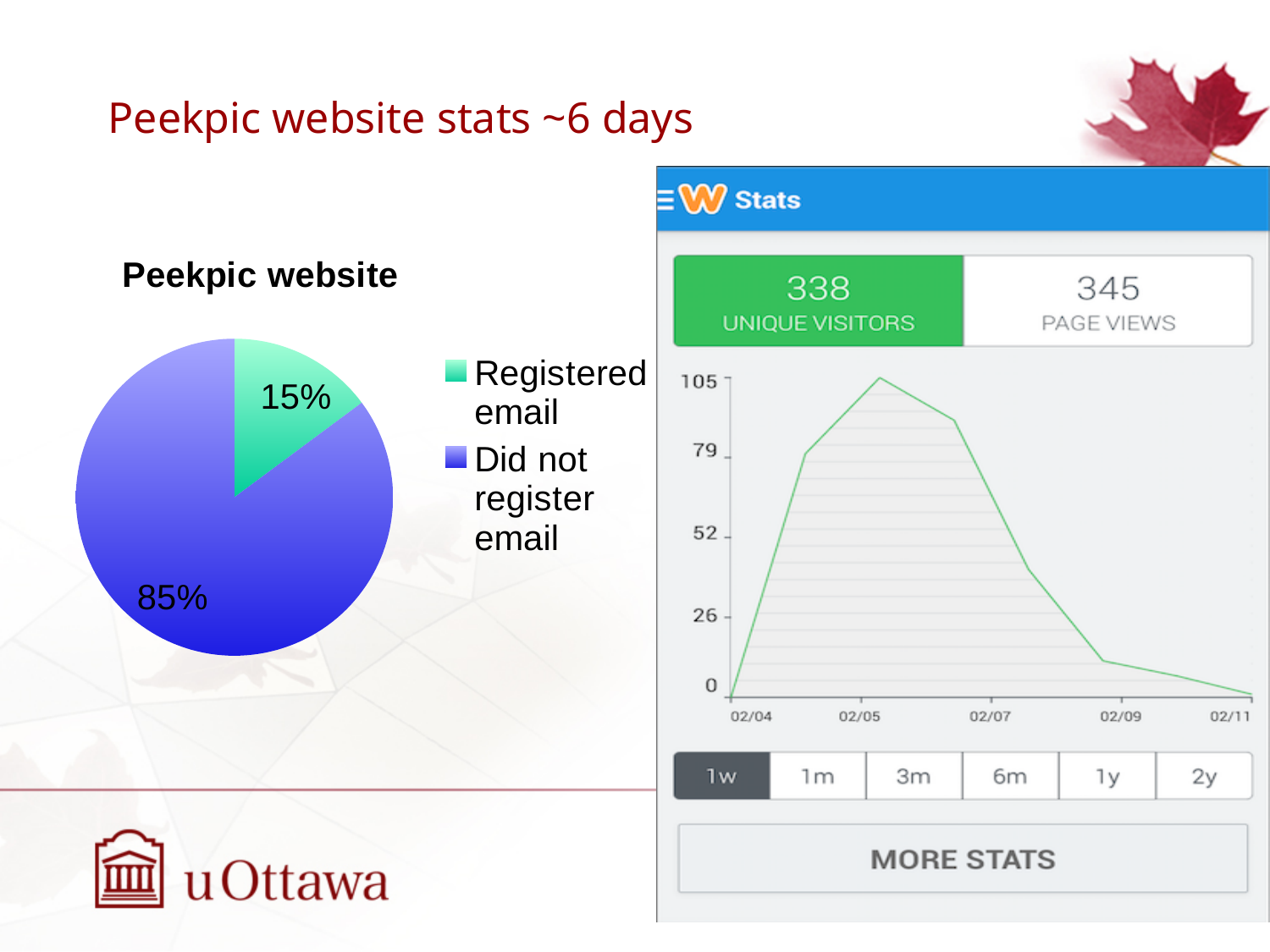
On the line chart in the Stats screenshot on the right, what is the highest value labelled on the vertical axis? 105 On the pie chart titled "Peekpic website", which slice is the largest? Did not register email What kind of chart is shown in the Stats screenshot on the right of the slide? line chart On the line chart in the Stats screenshot on the right, is the value at 02/09 greater or less than 26? less On the line chart in the Stats screenshot on the right, is the peak value greater or less than 79? greater What kind of chart is the chart titled "Peekpic website" on the left of the slide? pie chart On the pie chart titled "Peekpic website", what share of the pie is "Registered email"? 15% On the pie chart titled "Peekpic website", how many categories does the legend list? 2 On the pie chart titled "Peekpic website", which slice is the smallest? Registered email On the line chart in the Stats screenshot on the right, do the values rise or fall between 02/07 and 02/11? fall On the pie chart titled "Peekpic website", what share of the pie is "Did not register email"? 85% On the pie chart titled "Peekpic website", what is the difference in percentage points between "Did not register email" and "Registered email"? 70